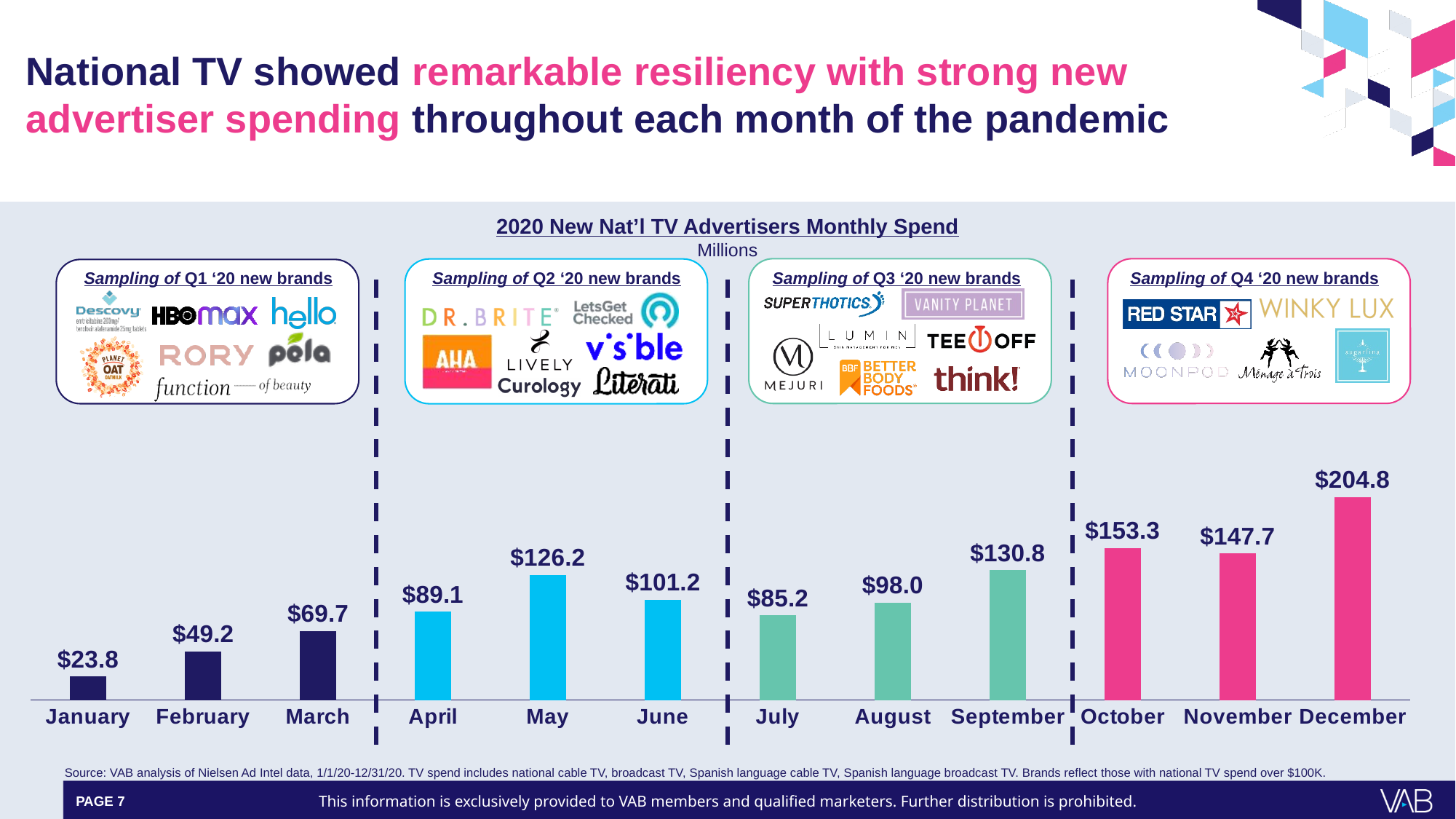
What is the difference between the May value and the June value? $25.0 What is the value for December in the 2020 New Nat'l TV Advertisers Monthly Spend chart? $204.8 What is the value for January in the chart? $23.8 How many months are plotted in the chart? 12 Which month has the lowest new advertiser spend in the chart? January What is the value for August in the chart? $98.0 Do the values rise or fall from January to March? rise What is the value for September in the chart? $130.8 What is the difference between the December value and the January value? $181.0 Which month has the highest new advertiser spend in the chart? December Which is larger, the value for May or the value for June? May What kind of chart is shown on the slide? bar chart